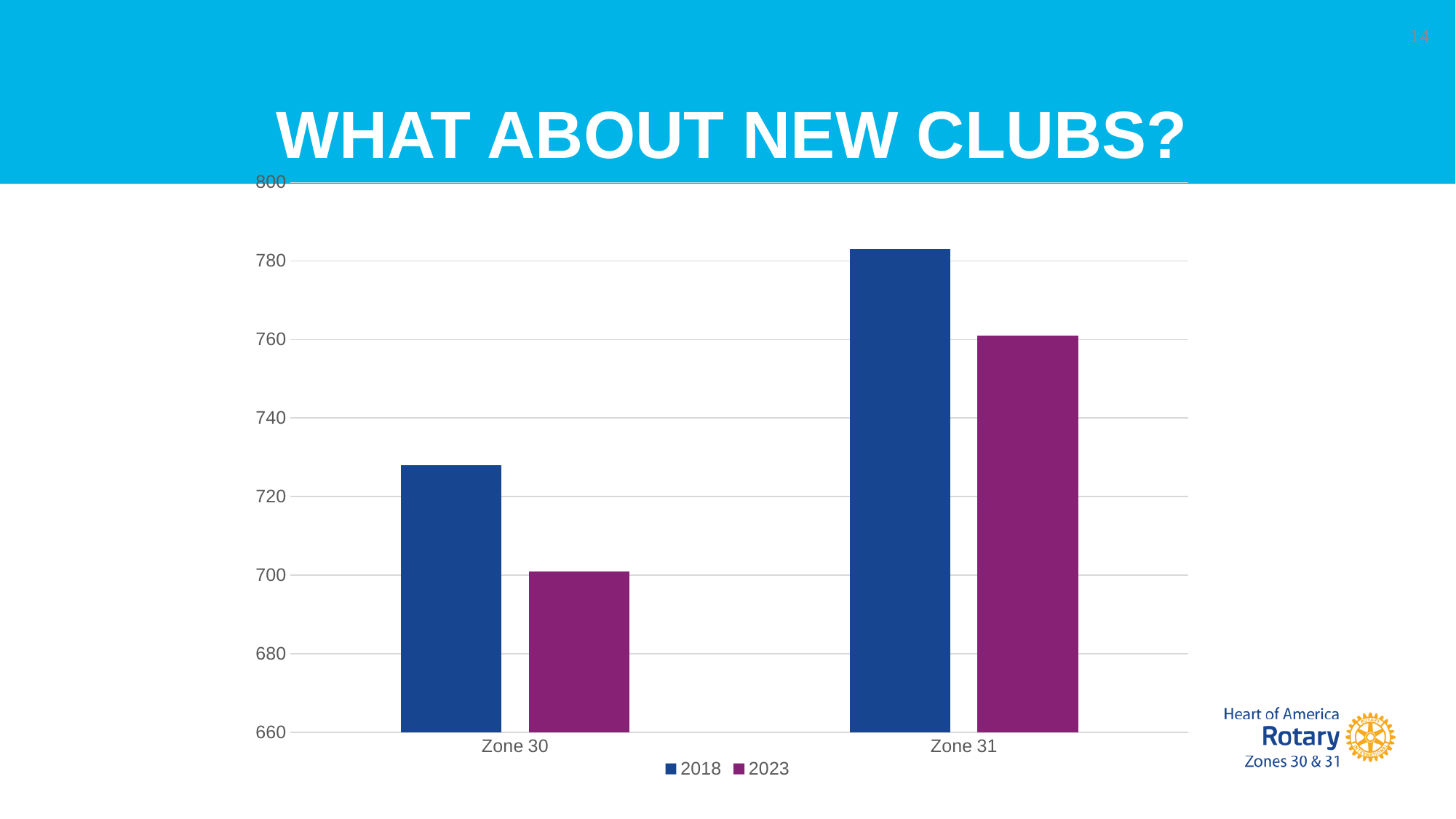
Is the 2023 value for Zone 30 greater or less than 720? less How many zones (categories) are shown on the x axis? 2 Is the 2018 value for Zone 31 greater or less than 760? greater Is the 2023 value for Zone 31 greater or less than 780? less How many series does the legend list? 2 Which zone has the highest 2018 value? Zone 31 Which zone has the lowest 2023 value? Zone 30 For Zone 31, which is larger, the 2018 value or the 2023 value? 2018 What is the title of the slide containing the chart? WHAT ABOUT NEW CLUBS? For Zone 30, which is larger, the 2018 value or the 2023 value? 2018 What kind of chart is shown on the slide? bar chart